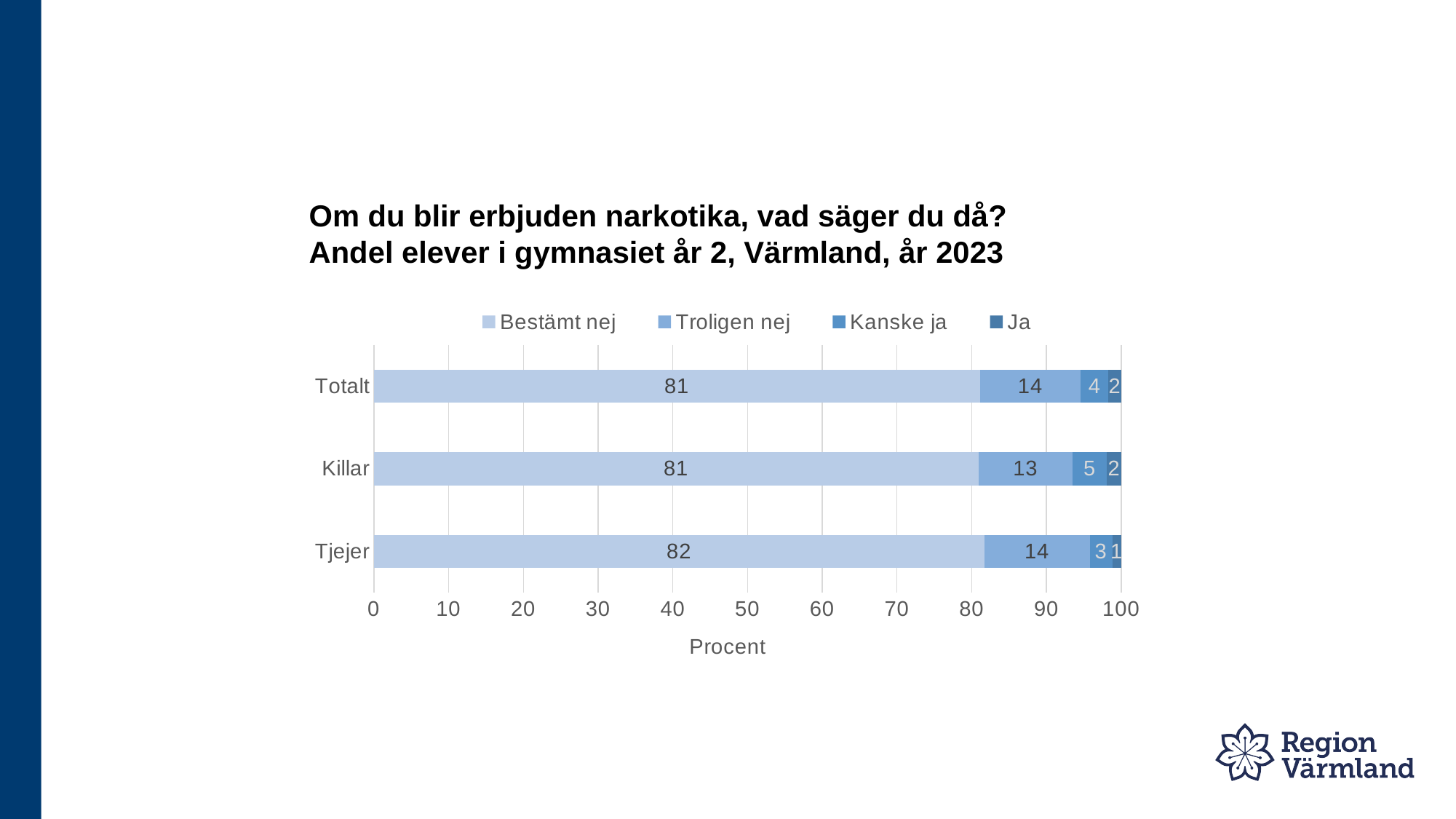
What is the value for "Kanske ja" for Totalt? 4 What is the difference between the "Kanske ja" values for Killar and Tjejer? 2 What is the value for "Troligen nej" for Killar? 13 What kind of chart is shown? Stacked bar chart Which category has the lowest value for "Troligen nej"? Killar Which is larger, the "Ja" value for Killar or for Tjejer? Killar How many series does the legend list? 4 How many categories are shown on the y axis? 3 What is the label of the x axis? Procent Which category has the highest value for "Bestämt nej"? Tjejer What is the value for "Ja" for Tjejer? 1 What is the value for "Bestämt nej" for Tjejer? 82